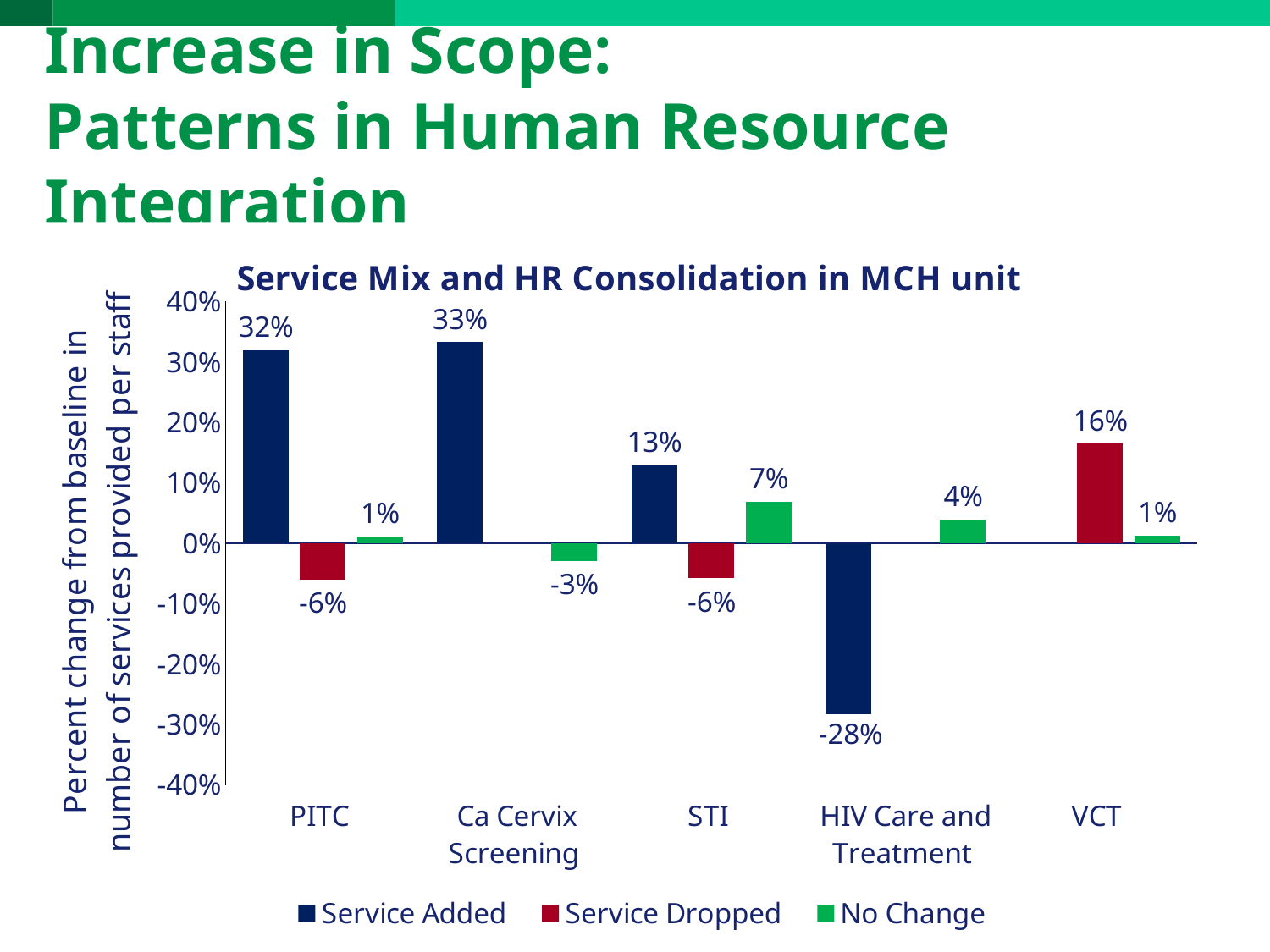
Which category has the lowest Service Added value? HIV Care and Treatment Which is larger, the Service Added value for PITC or the Service Added value for STI? PITC What is the Service Added value for Ca Cervix Screening? 33% Which category has the highest No Change value? STI What is the difference between the Service Added values for Ca Cervix Screening and STI? 20% What is the Service Added value for HIV Care and Treatment? -28% What is the No Change value for STI? 7% What is the No Change value for Ca Cervix Screening? -3% What type of chart is shown on the slide? Bar chart How many series does the legend list? 3 What is the Service Dropped value for VCT? 16% What is the Service Added value for PITC? 32%